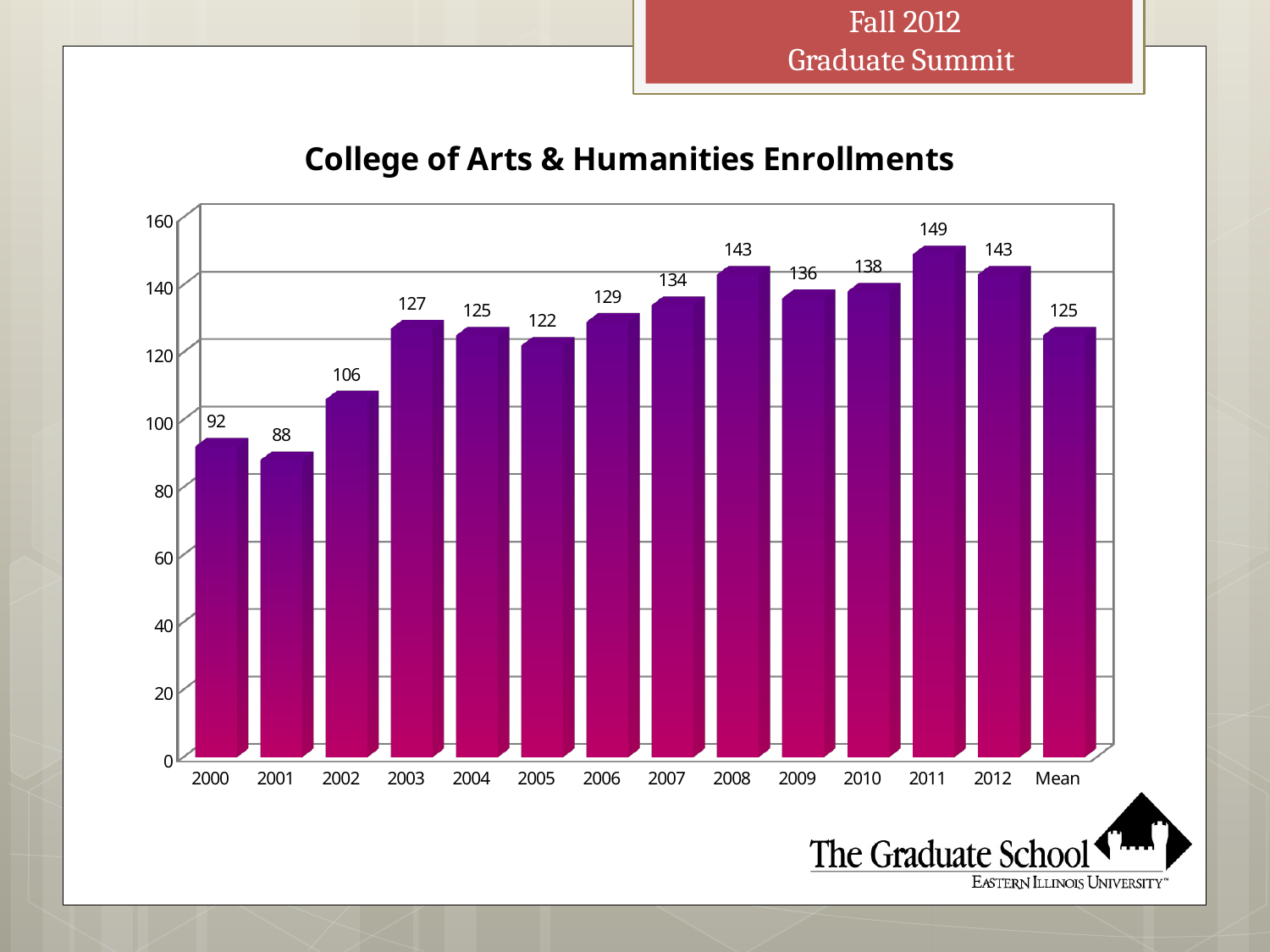
What is the value shown for the Mean bar? 125 Do enrollments generally rise or fall from 2001 to 2011? Rise Which year has the lowest enrollment? 2001 What is the difference between the enrollment in 2011 and the enrollment in 2000? 57 Is the value for 2002 greater or less than 100? greater What is the title of the chart? College of Arts & Humanities Enrollments Which is larger, the enrollment in 2009 or the enrollment in 2010? 2010 What kind of chart is shown on the slide? Bar chart How many bars are shown in the chart? 14 What is the enrollment value for 2003? 127 Which year has the highest enrollment? 2011 What is the enrollment value for 2008? 143